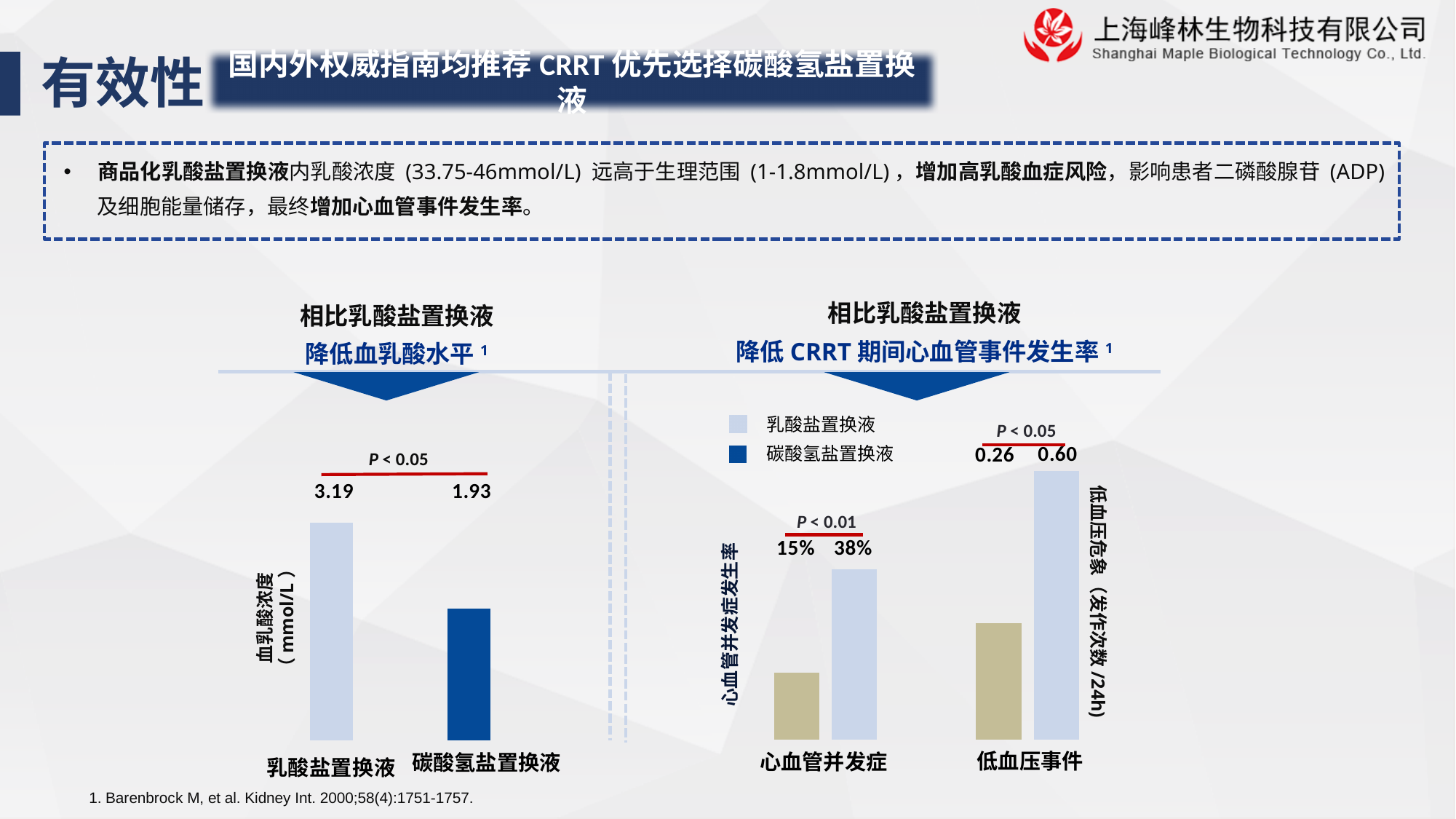
In the left chart (血乳酸浓度), what P value is shown above the bars? P < 0.05 In the right chart (心血管事件), what is the difference between the two values for 低血压事件? 0.34 In the right chart (心血管事件), what is the difference between the two values for 心血管并发症? 23% In the right chart (心血管事件), what are the two values shown for 心血管并发症? 15% and 38% What type of chart is used on the left side of the slide (血乳酸浓度)? Bar chart In the left chart (血乳酸浓度), what is the difference between the values for 乳酸盐置换液 and 碳酸氢盐置换液? 1.26 In the left chart (血乳酸浓度), what is the value for 乳酸盐置换液? 3.19 In the left chart (血乳酸浓度), how many bars are plotted? 2 In the left chart (血乳酸浓度), what is the value for 碳酸氢盐置换液? 1.93 In the right chart (心血管事件), how many series does the legend list? 2 In the right chart (心血管事件), what are the two values shown for 低血压事件? 0.26 and 0.60 In the left chart (血乳酸浓度), which category has the higher value? 乳酸盐置换液